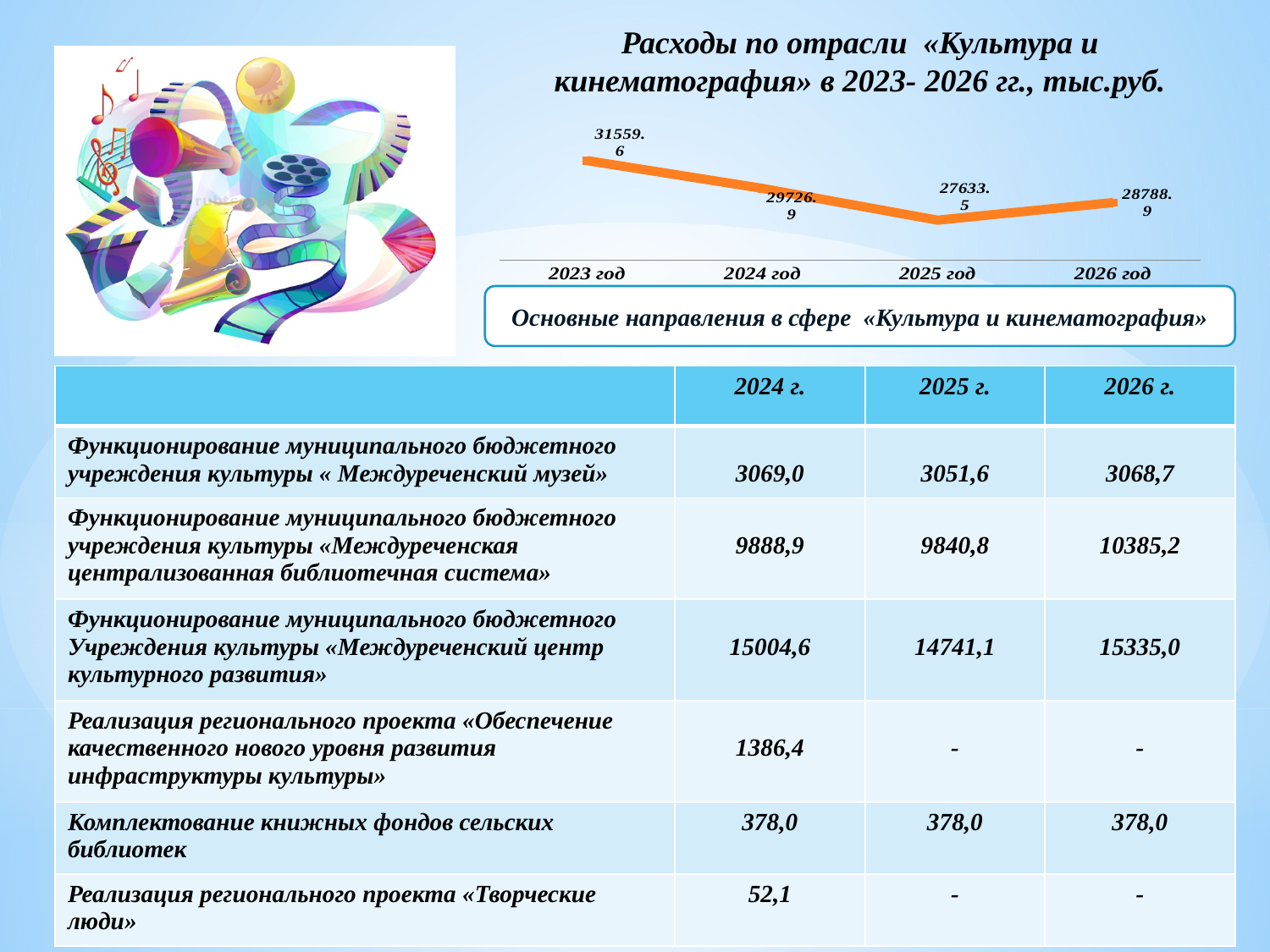
Do the values on the chart rise or fall from 2023 год to 2025 год? fall Which is larger, the value for 2024 год or the value for 2026 год? 2024 год Which year has the highest value on the chart? 2023 год What is the difference between the values for 2026 год and 2025 год? 1155.4 How many years are plotted on the chart? 4 What is the value for 2024 год on the chart? 29726.9 What type of chart is shown on the slide? line chart Which year has the lowest value on the chart? 2025 год What is the value for 2025 год on the chart? 27633.5 What is the difference between the values for 2023 год and 2024 год? 1832.7 What is the value for 2026 год on the chart? 28788.9 What is the value for 2023 год on the chart? 31559.6